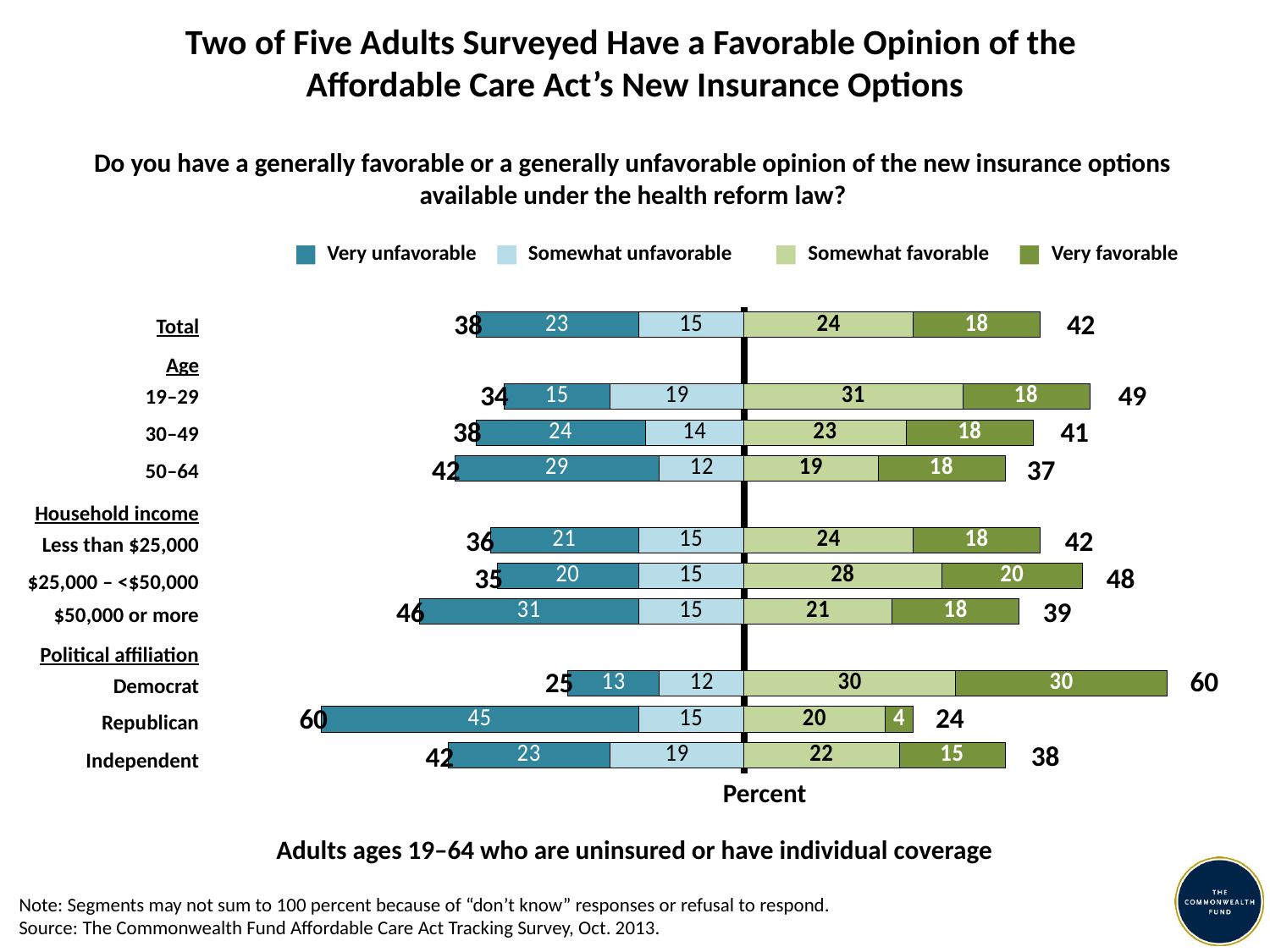
Which is larger: the 'Somewhat favorable' value for Democrats or for Independents? Democrats Which group has the highest 'Very unfavorable' value? Republican How many series does the legend list? 4 What is the combined favorable total (somewhat plus very favorable) shown for the Total row? 42 Which group has the lowest 'Very favorable' value? Republican What percentage of Republicans are very unfavorable toward the new insurance options? 45 What is the 'Somewhat favorable' value for adults ages 19–29? 31 What type of chart is shown on the slide? Stacked bar chart How many groups (bars) are plotted in the chart, including Total? 10 What is the 'Very favorable' value for Democrats? 30 What is the combined unfavorable total shown for the 50–64 age group? 42 What is the difference between the 'Very unfavorable' values for the $50,000 or more group and the Less than $25,000 group? 10